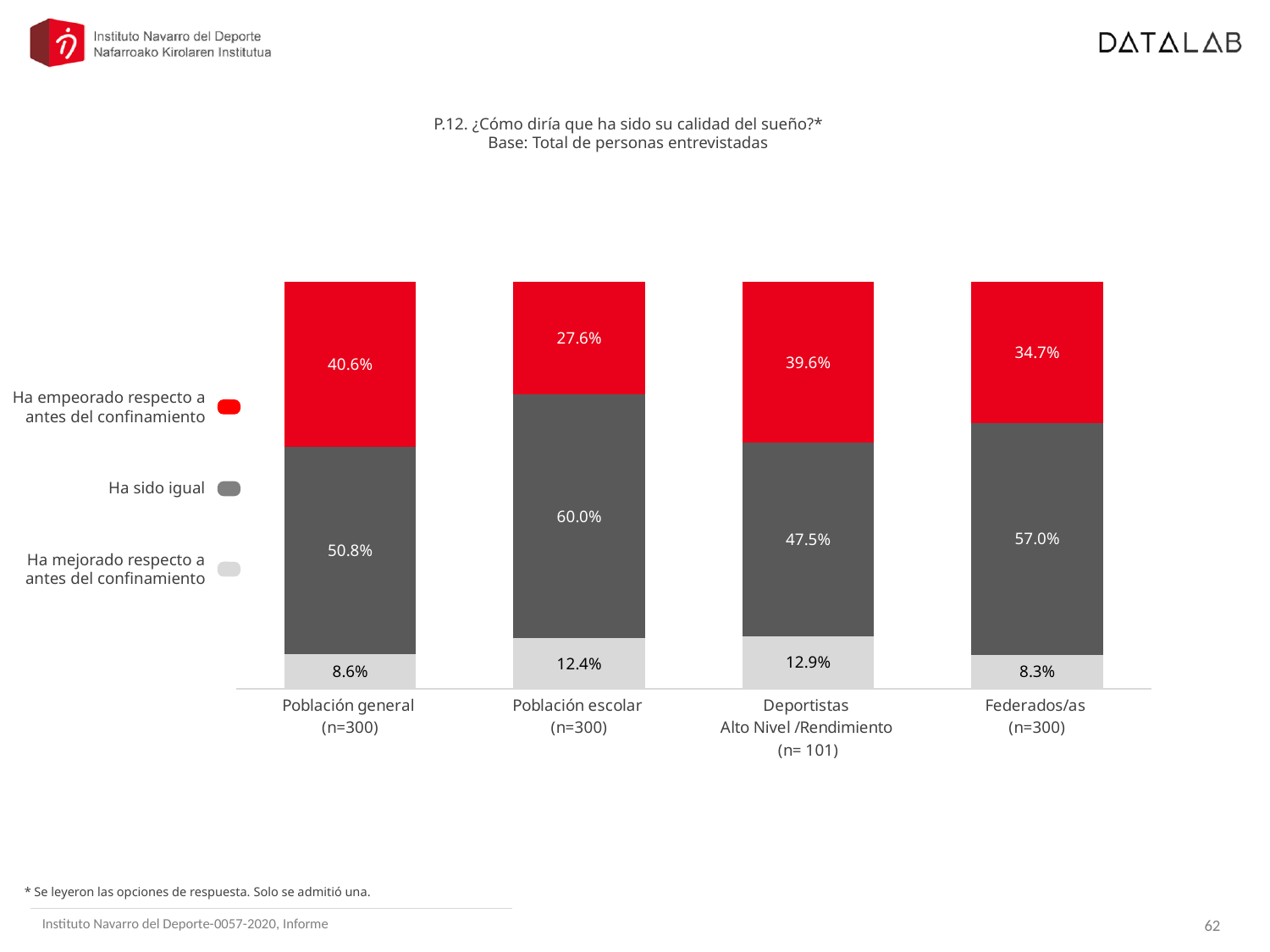
What is the difference between the 'Ha sido igual' values for Población escolar and Población general? 9.2% How many categories are shown along the x axis? 4 What kind of chart is shown on the slide? Stacked bar chart What is the value for 'Ha sido igual' in the Población escolar category? 60.0% What is the value for 'Ha sido igual' in the Federados/as category? 57.0% Which category has the highest value for 'Ha empeorado respecto a antes del confinamiento'? Población general How many series does the legend list? 3 What colour represents 'Ha empeorado respecto a antes del confinamiento' in the legend? Red Which is larger: the 'Ha empeorado respecto a antes del confinamiento' value for Deportistas Alto Nivel /Rendimiento or for Federados/as? Deportistas Alto Nivel /Rendimiento What is the value for 'Ha empeorado respecto a antes del confinamiento' in the Población general category? 40.6% What is the value for 'Ha mejorado respecto a antes del confinamiento' in the Deportistas Alto Nivel /Rendimiento category? 12.9% Which category has the lowest value for 'Ha mejorado respecto a antes del confinamiento'? Federados/as